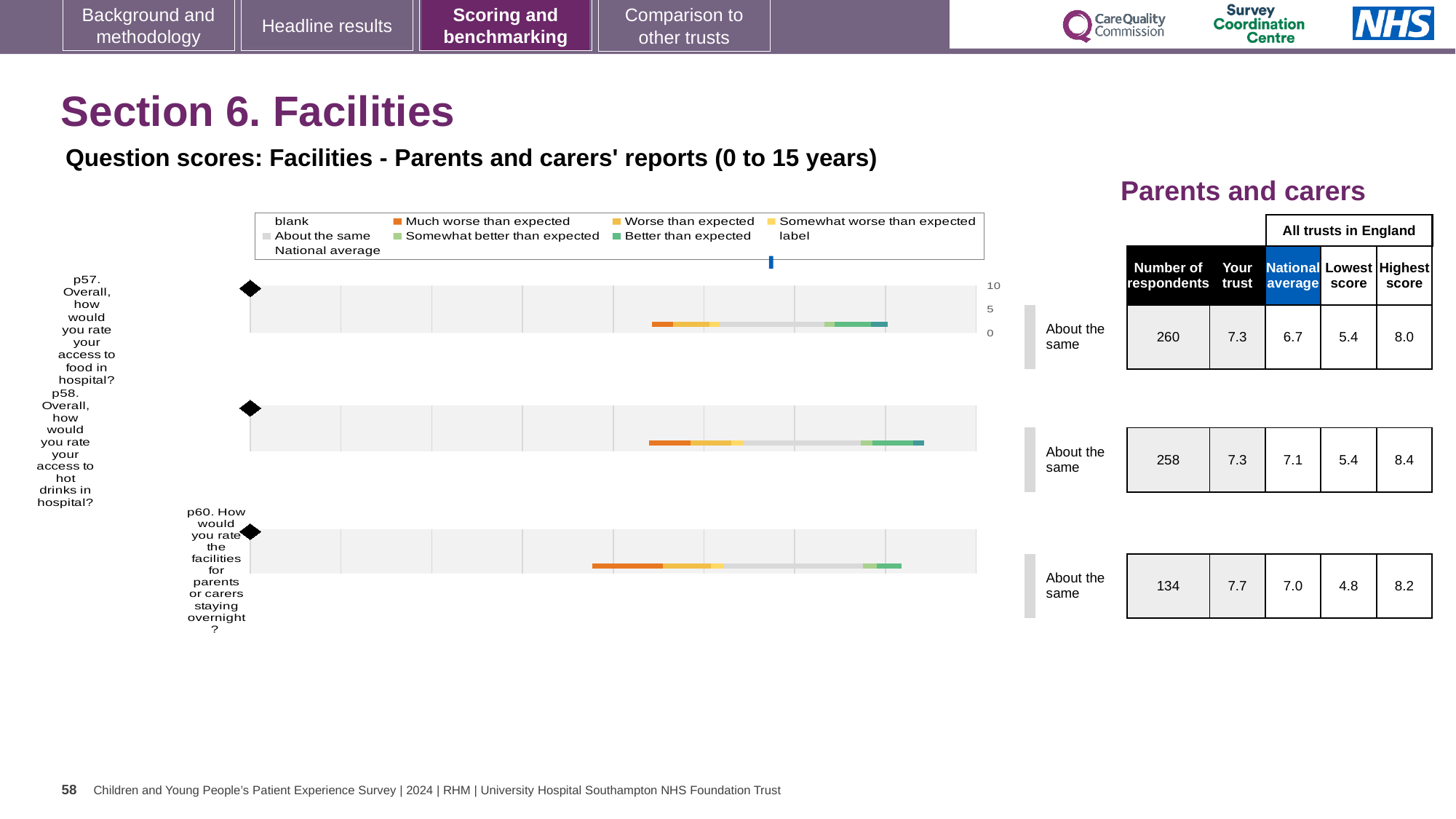
What is the 'Your trust' score for p60 (facilities for parents or carers staying overnight)? 7.7 What benchmark category is shown for all three questions in the Facilities chart? About the same What is the difference between the 'Your trust' score and the national average for p57? 0.6 How many respondents answered p57 (access to food in hospital)? 260 Which legend entry in the Facilities chart is shown in orange? Much worse than expected Which question has the highest 'Your trust' score? p60 (facilities for parents or carers staying overnight) What is the lowest score among all trusts in England for p60? 4.8 Which question has the fewest respondents? p60 (facilities for parents or carers staying overnight) For p58, which is larger: the 'Your trust' score or the national average? Your trust What is the national average score for p58 (access to hot drinks in hospital)? 7.1 What kind of chart is used to show the question scores for Facilities? Bar chart How many questions (bars) are plotted in the Facilities chart? 3